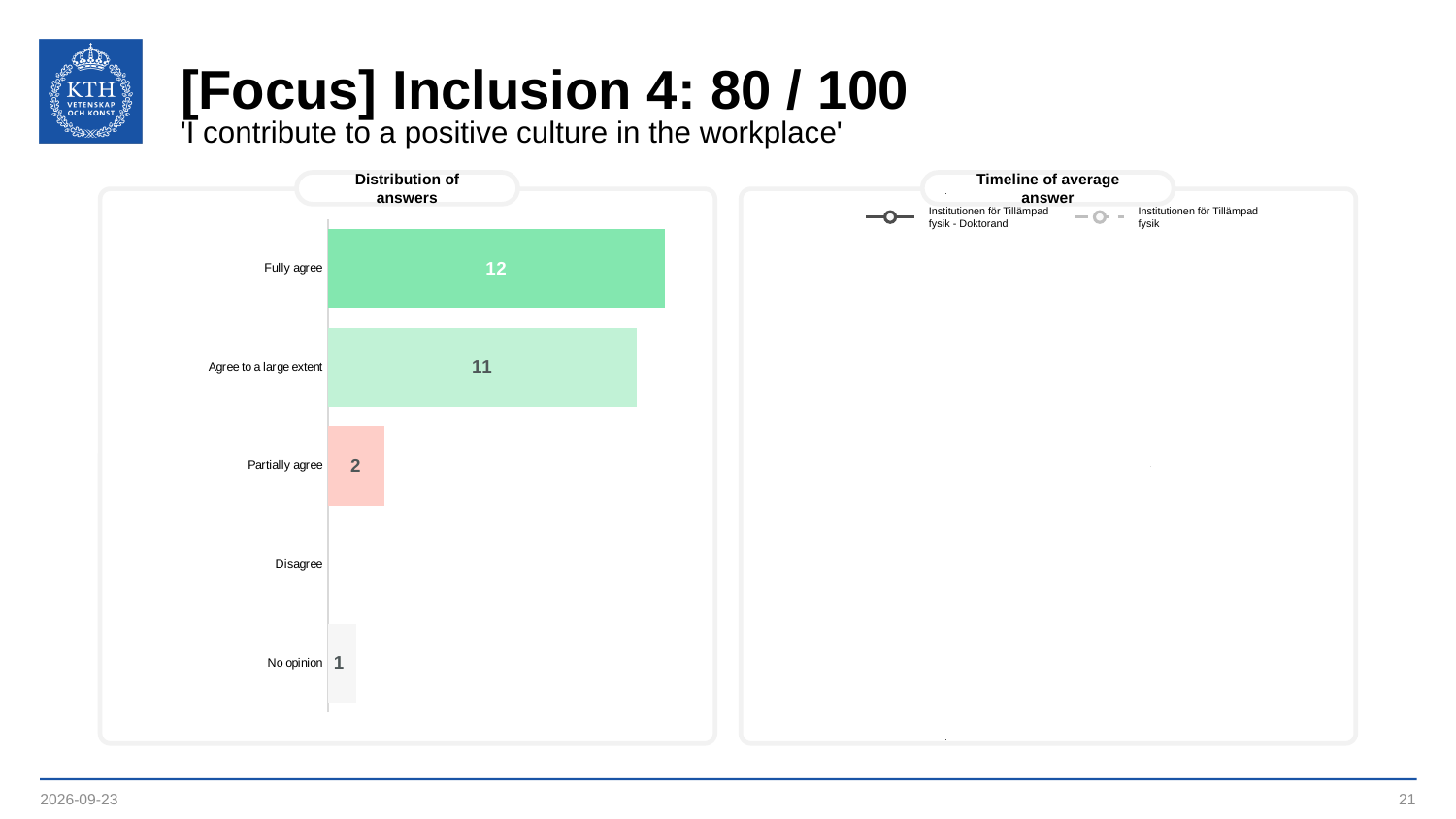
In the 'Distribution of answers' chart, how many respondents answered 'Fully agree'? 12 In the 'Distribution of answers' chart, which is larger: the value for 'Partially agree' or the value for 'No opinion'? Partially agree In the 'Distribution of answers' chart, what is the value for 'Agree to a large extent'? 11 In the 'Distribution of answers' chart, what is the value for 'Partially agree'? 2 What kind of chart is the 'Distribution of answers' chart? Bar chart In the 'Distribution of answers' chart, which answer category has the highest value? Fully agree How many answer categories are listed on the y axis of the 'Distribution of answers' chart? 5 In the 'Distribution of answers' chart, what is the difference between the values for 'Fully agree' and 'Agree to a large extent'? 1 What are the two legend entries in the 'Timeline of average answer' chart? Institutionen för Tillämpad fysik - Doktorand; Institutionen för Tillämpad fysik In the 'Distribution of answers' chart, what is the value for 'No opinion'? 1 In the 'Distribution of answers' chart, what is the difference between the values for 'Agree to a large extent' and 'Partially agree'? 9 How many series does the legend of the 'Timeline of average answer' chart list? 2